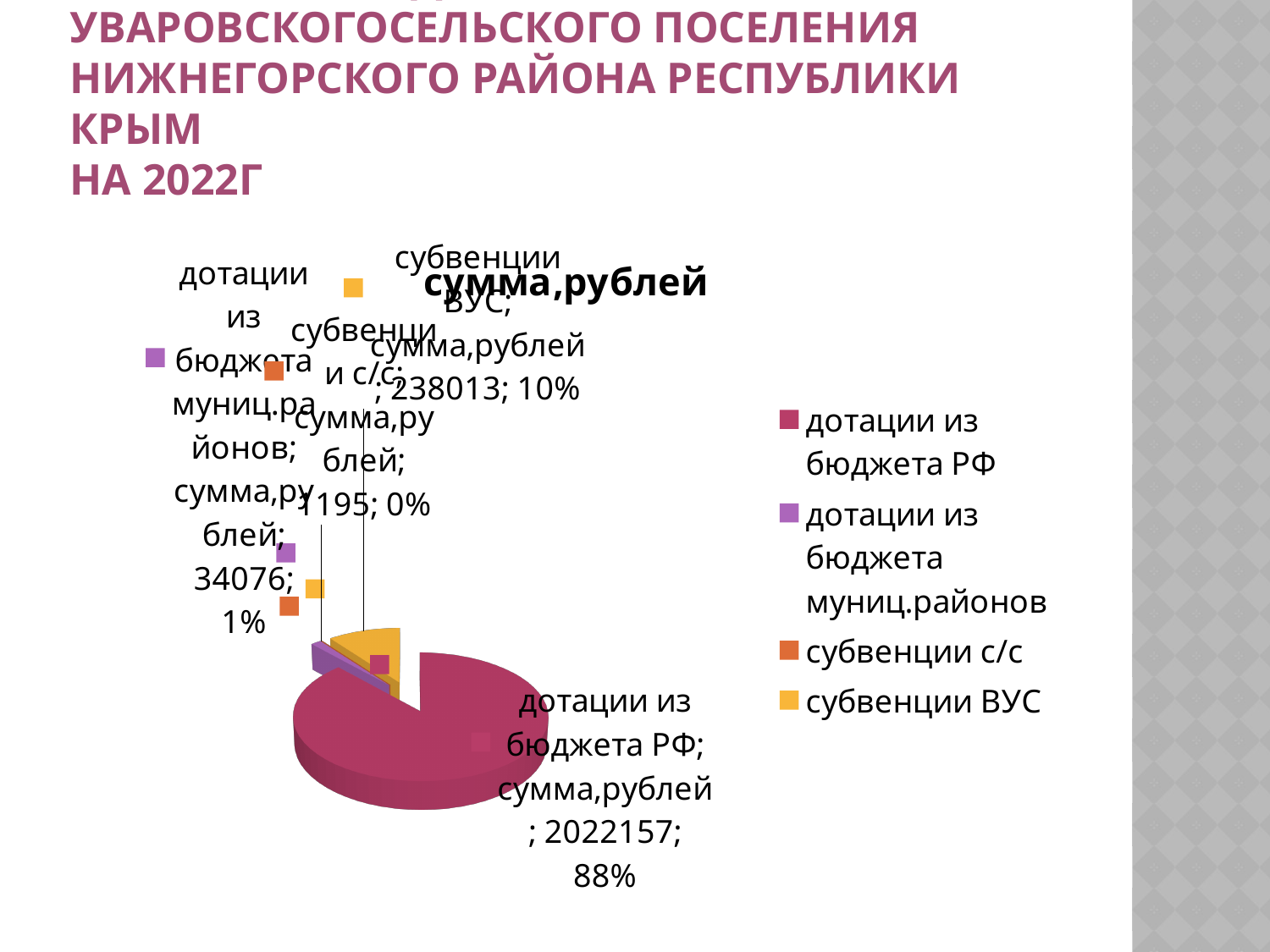
What kind of chart is shown on the slide? pie chart What is the value for дотации из бюджета РФ? 2022157 What is the value for субвенции с/с? 1195 What is the difference between the values for субвенции ВУС and дотации из бюджета муниц.районов? 203937 What is the title of the chart? сумма,рублей What share of the pie does дотации из бюджета РФ represent? 88% What is the value for субвенции ВУС? 238013 How many categories does the legend of the pie chart list? 4 What share of the pie does субвенции ВУС represent? 10% Which category has the smallest slice of the pie? субвенции с/с What is the value for дотации из бюджета муниц.районов? 34076 Which category has the largest slice of the pie? дотации из бюджета РФ